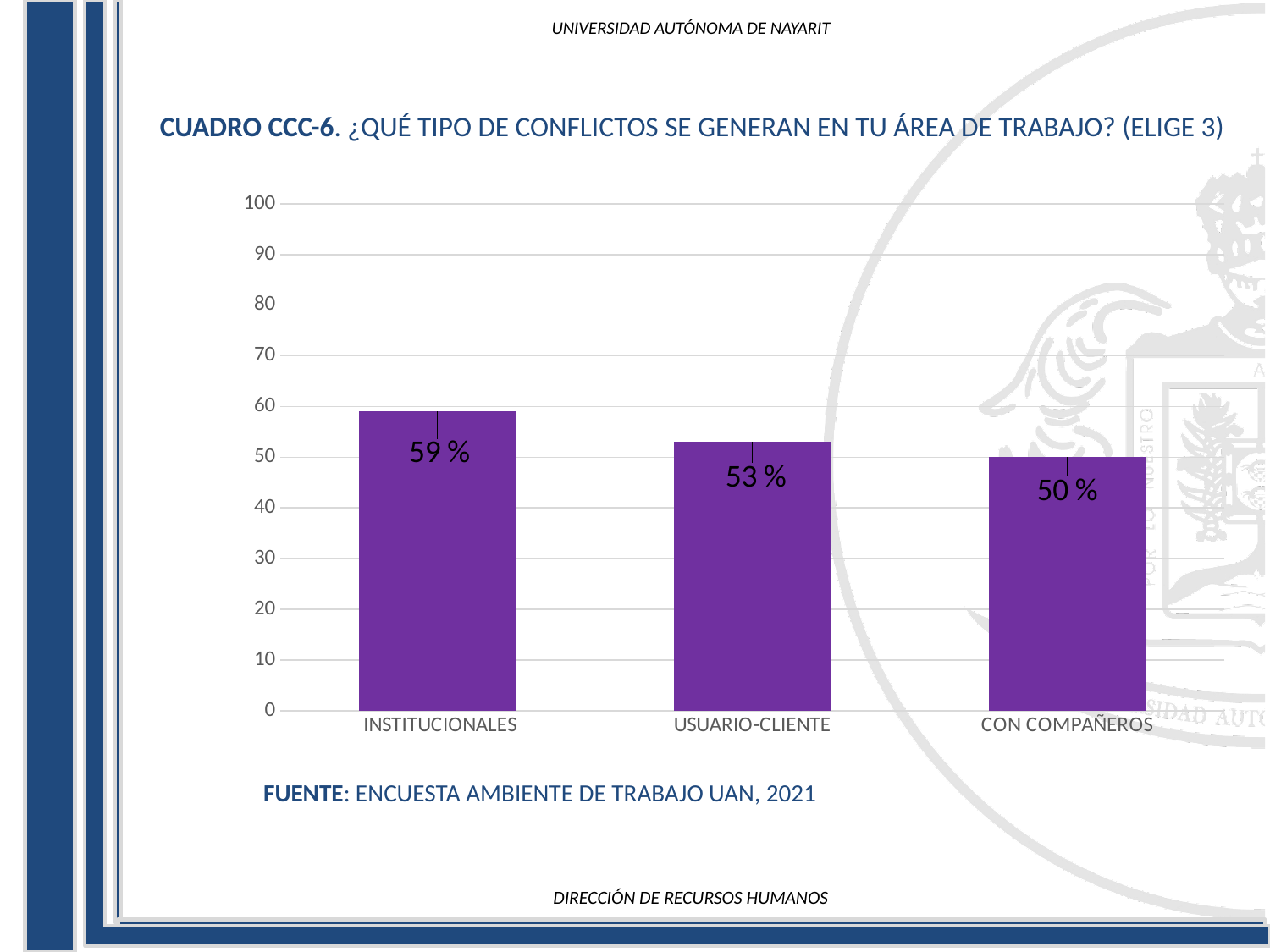
What is the value for INSTITUCIONALES? 59 % What kind of chart is shown on the slide? bar chart What is the value for USUARIO-CLIENTE? 53 % How many categories are shown in the chart? 3 Which is larger, the value for INSTITUCIONALES or the value for USUARIO-CLIENTE? INSTITUCIONALES Do the values rise or fall from left to right across the categories? fall What is the value for CON COMPAÑEROS? 50 % Which category has the highest value? INSTITUCIONALES Is the value for INSTITUCIONALES greater or less than 50? greater What is the difference between the values for INSTITUCIONALES and CON COMPAÑEROS? 9 % What is the difference between the values for USUARIO-CLIENTE and CON COMPAÑEROS? 3 % Which category has the lowest value? CON COMPAÑEROS